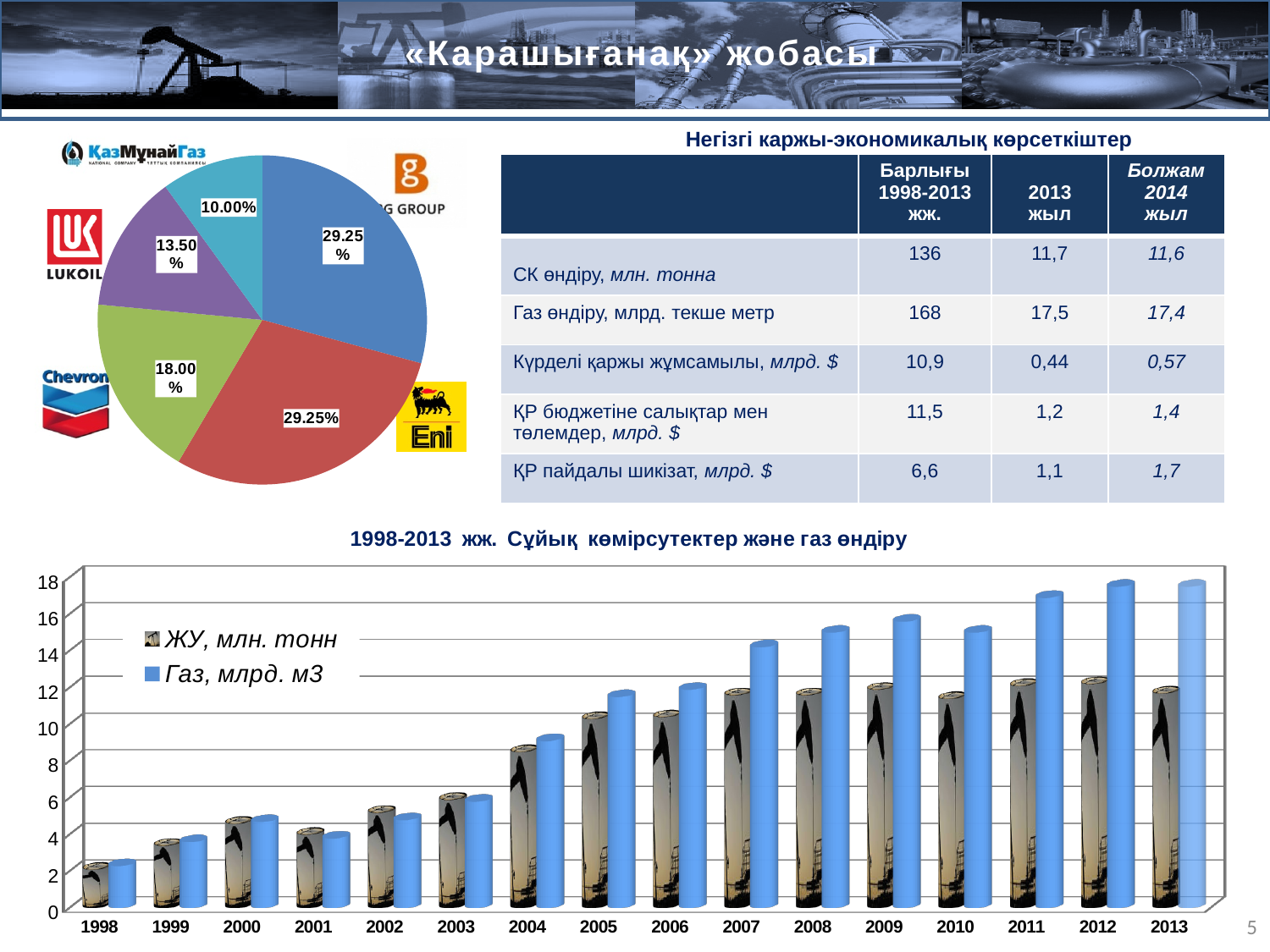
In the bottom bar chart, is the value for "ЖУ, млн. тонн" in 2013 greater or less than 14? less In the bottom bar chart, which year has the lowest value for "Газ, млрд. м3"? 1998 In the bottom bar chart, which series has the larger value in 2013, "ЖУ, млн. тонн" or "Газ, млрд. м3"? Газ, млрд. м3 In the bottom bar chart, do the values for "Газ, млрд. м3" generally rise or fall from 1998 to 2013? rise How many years are shown on the x axis of the bottom bar chart? 16 How many slices does the pie chart on the left of the slide have? 5 How many series does the legend of the bottom bar chart list? 2 In the bottom bar chart, is the value for "Газ, млрд. м3" in 2013 greater or less than 16? greater In the bottom bar chart, is the value for "Газ, млрд. м3" in 1998 greater or less than 4? less In the pie chart on the left, what is the difference between the green slice (18.00%) and the light blue slice (10.00%)? 8.00% In the pie chart on the left, what is the share of the smallest slice? 10.00% What kind of chart is the chart at the bottom of the slide titled "1998-2013 жж. Сұйық көмірсутектер және газ өндіру"? bar chart